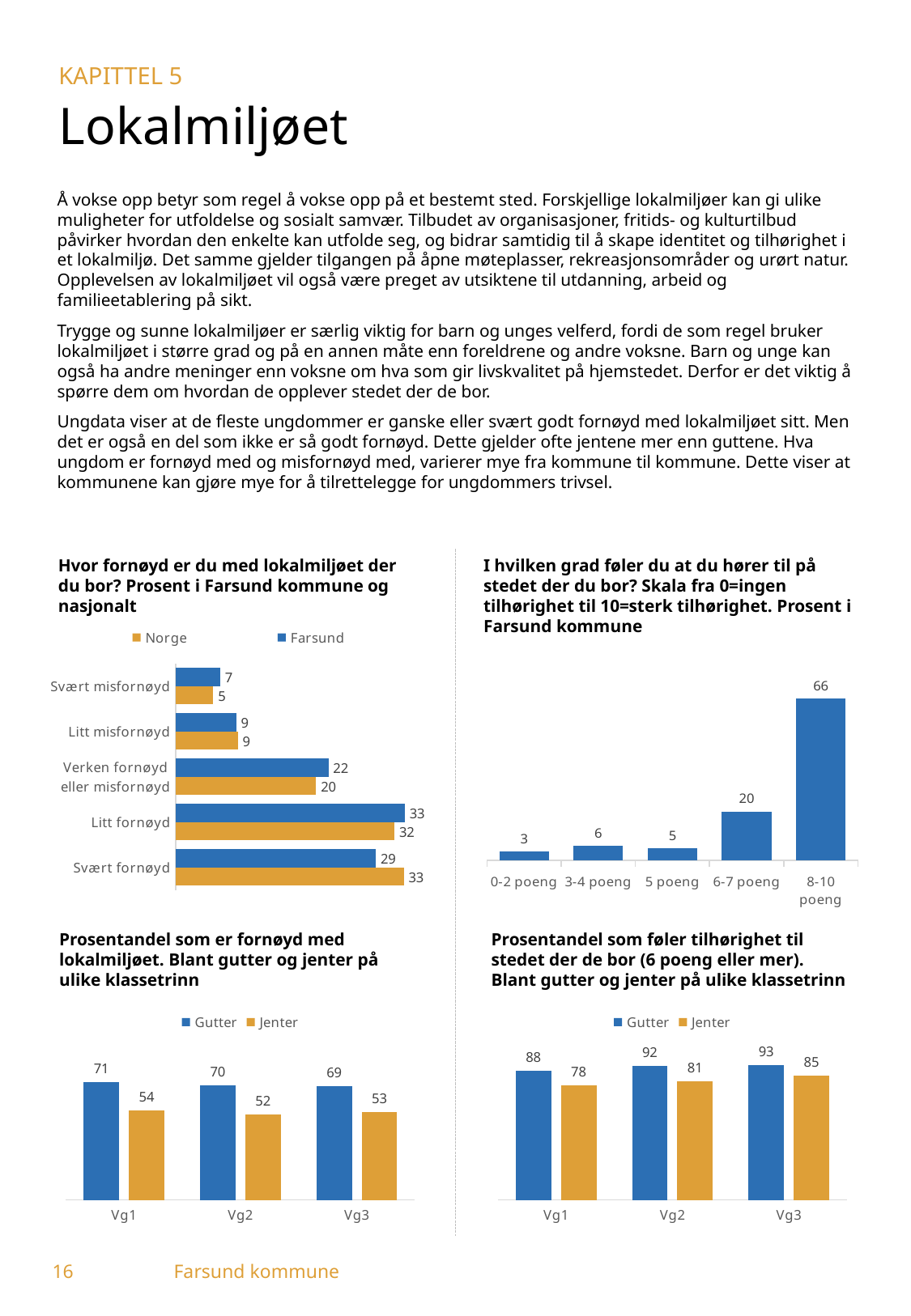
In the bottom-left chart (Prosentandel som er fornøyd med lokalmiljøet), what is the difference between Gutter and Jenter at Vg1? 17 In the top-right chart (I hvilken grad føler du at du hører til på stedet der du bor?), what is the value for 6-7 poeng? 20 What kind of chart is the bottom-right chart (Prosentandel som føler tilhørighet til stedet der de bor)? Bar chart In the top-left chart (Hvor fornøyd er du med lokalmiljøet der du bor?), which is larger for Svært fornøyd: Norge or Farsund? Norge In the top-left chart (Hvor fornøyd er du med lokalmiljøet der du bor?), what is the Farsund value for Svært fornøyd? 29 In the top-left chart (Hvor fornøyd er du med lokalmiljøet der du bor?), how many series does the legend list? 2 In the top-right chart (I hvilken grad føler du at du hører til på stedet der du bor?), which category has the highest value? 8-10 poeng In the top-left chart (Hvor fornøyd er du med lokalmiljøet der du bor?), what is the Norge value for Verken fornøyd eller misfornøyd? 20 In the top-right chart (I hvilken grad føler du at du hører til på stedet der du bor?), what is the difference between the values for 8-10 poeng and 6-7 poeng? 46 In the bottom-right chart (Prosentandel som føler tilhørighet til stedet der de bor), what is the value for Gutter at Vg3? 93 In the top-right chart (I hvilken grad føler du at du hører til på stedet der du bor?), how many categories are shown? 5 In the bottom-left chart (Prosentandel som er fornøyd med lokalmiljøet), what is the value for Jenter at Vg2? 52